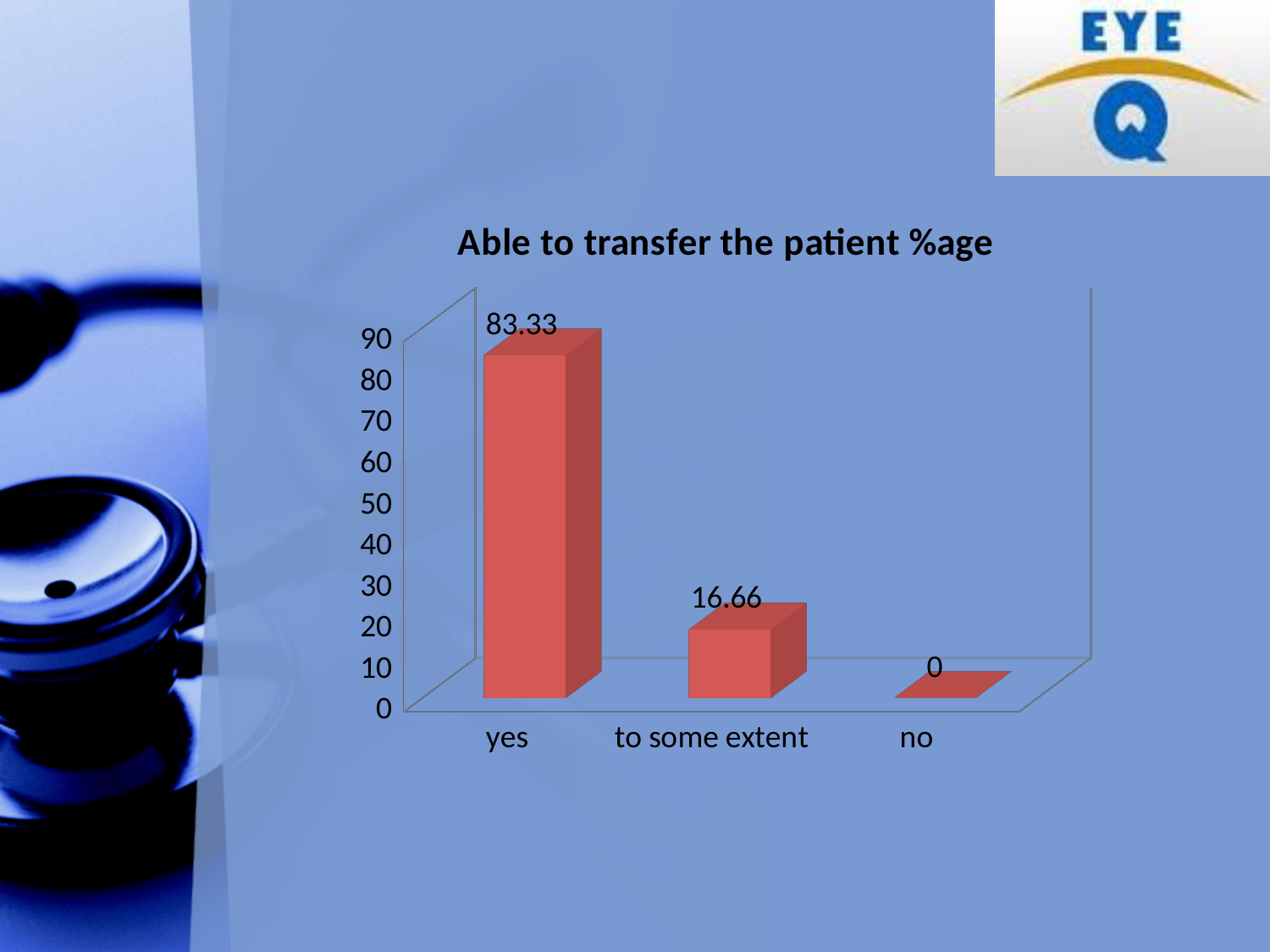
What is the title of the chart? Able to transfer the patient %age Is the value for "yes" greater or less than 50? greater Which is larger, the value for "to some extent" or the value for "no"? to some extent Do the values rise or fall from left to right along the x axis? fall What is the difference between the values for "yes" and "to some extent"? 66.67 How many categories are shown on the x axis? 3 What is the value for "to some extent"? 16.66 What is the value for "no"? 0 Which category has the lowest value? no What is the value for "yes"? 83.33 Which category has the highest value? yes What kind of chart is shown on the slide? bar chart